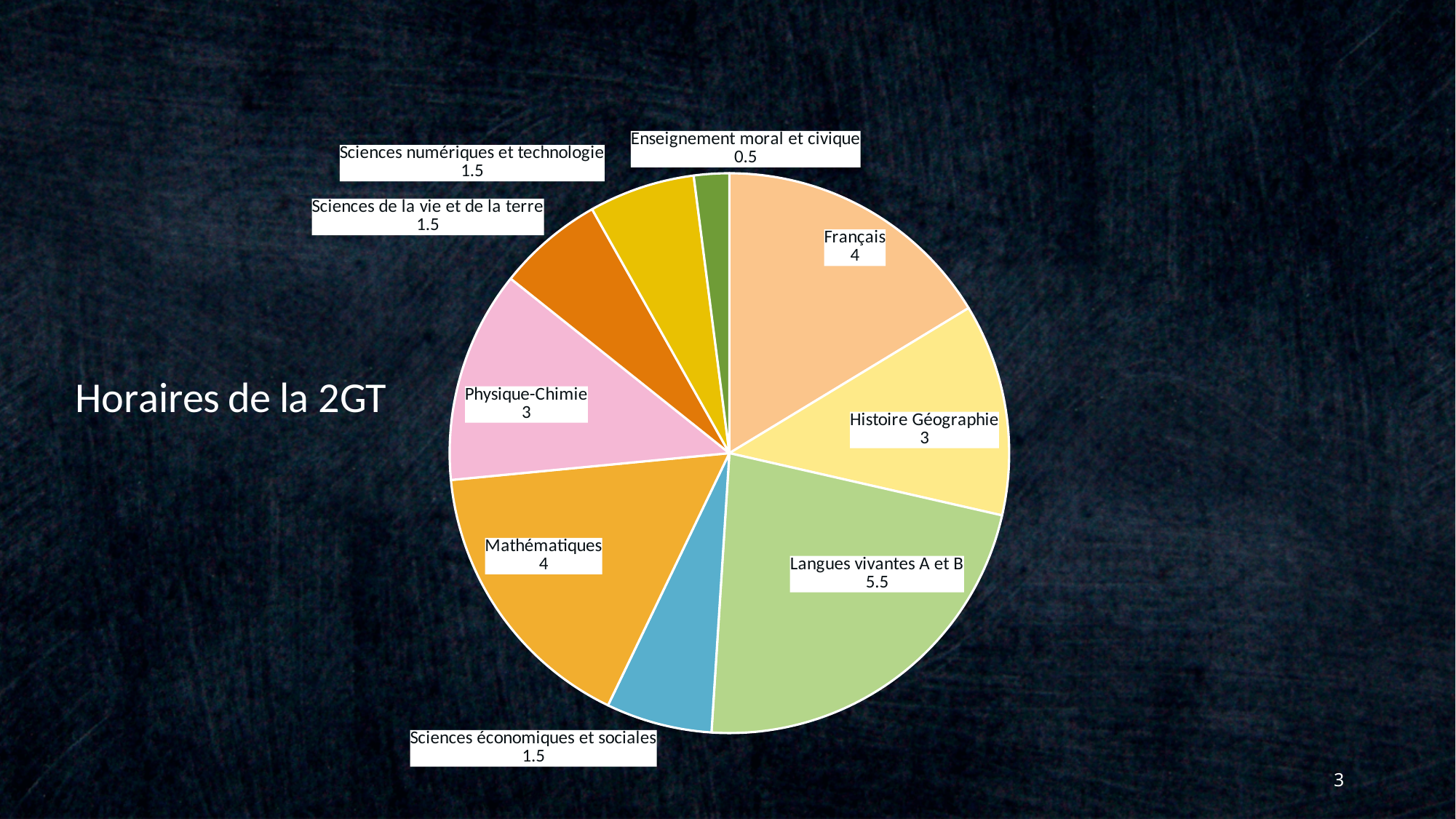
Which is larger, the value for Physique-Chimie or the value for Sciences de la vie et de la terre? Physique-Chimie What is the difference between the values for Langues vivantes A et B and Mathématiques? 1.5 What kind of chart is shown on the slide? pie chart What is the value for Histoire Géographie? 3 What is the title text shown to the left of the pie chart? Horaires de la 2GT What is the total of all the values shown in the pie chart? 24.5 Which category has the largest slice of the pie? Langues vivantes A et B What is the value for Enseignement moral et civique? 0.5 What is the value for Sciences économiques et sociales? 1.5 How many slices does the pie chart have? 9 What is the value for Langues vivantes A et B? 5.5 Which category has the smallest slice of the pie? Enseignement moral et civique